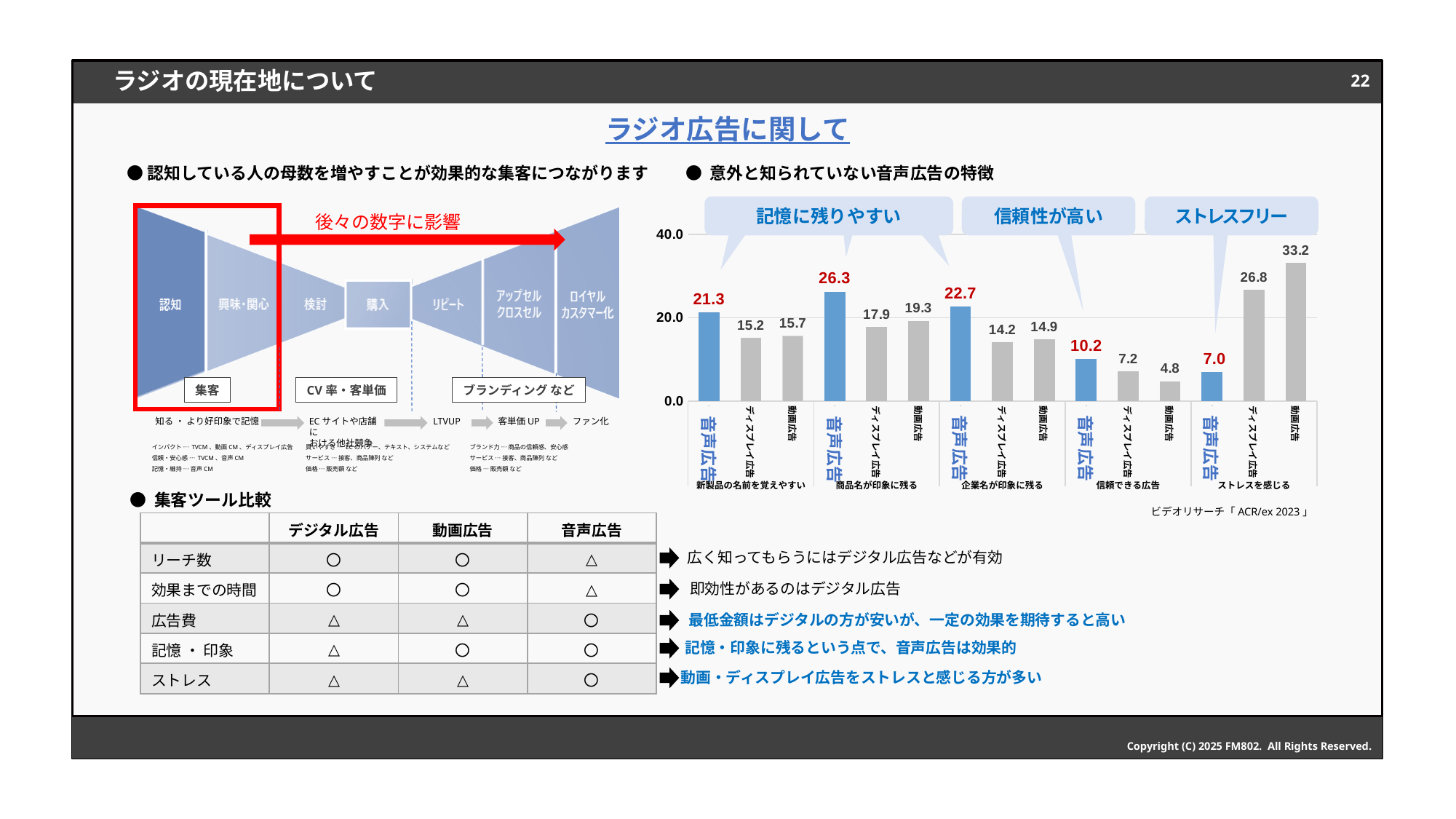
In the bar chart, what is the value for ディスプレイ広告 under 信頼できる広告? 7.2 In the bar chart, what is the value for 動画広告 under ストレスを感じる? 33.2 In the bar chart, is the value for 音声広告 under 商品名が印象に残る greater or less than 20.0? greater In the bar chart, what is the value for 音声広告 under 企業名が印象に残る? 22.7 In the bar chart, which bar has the lowest value overall? 動画広告 under 信頼できる広告 (4.8) How many category groups are shown along the x axis of the bar chart? 5 In the bar chart, what is the difference between 音声広告 and ディスプレイ広告 under 新製品の名前を覚えやすい? 6.1 In the bar chart, what is the difference between 動画広告 and 音声広告 under ストレスを感じる? 26.2 In the bar chart, which bar has the highest value overall? 動画広告 under ストレスを感じる (33.2) What kind of chart is shown on the right side of the slide? bar chart In the bar chart, what is the value for 音声広告 under 商品名が印象に残る? 26.3 In the bar chart, under 信頼できる広告, which is larger: 音声広告 or 動画広告? 音声広告